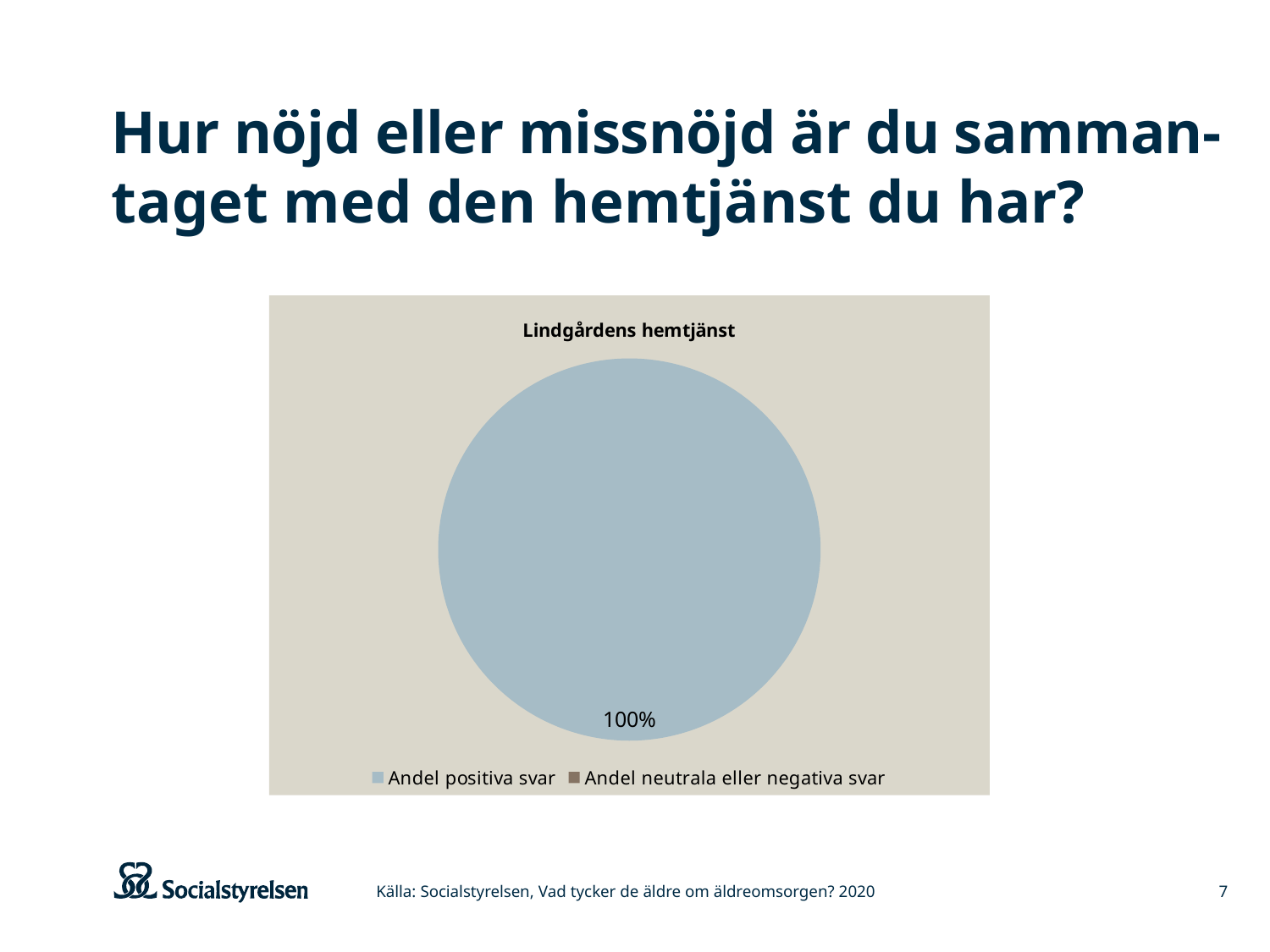
What share of the pie does Andel positiva svar take up? 100% What kind of chart is shown on the slide? pie chart Which category has the largest share of the pie? Andel positiva svar How many slices are visible in the pie? 1 Is the share for Andel positiva svar greater or less than 50%? greater What is the title of the chart? Lindgårdens hemtjänst What percentage is shown for Andel positiva svar? 100% What colour represents Andel positiva svar in the chart? light blue-grey How many entries does the chart legend list? 2 Which is larger, Andel positiva svar or Andel neutrala eller negativa svar? Andel positiva svar